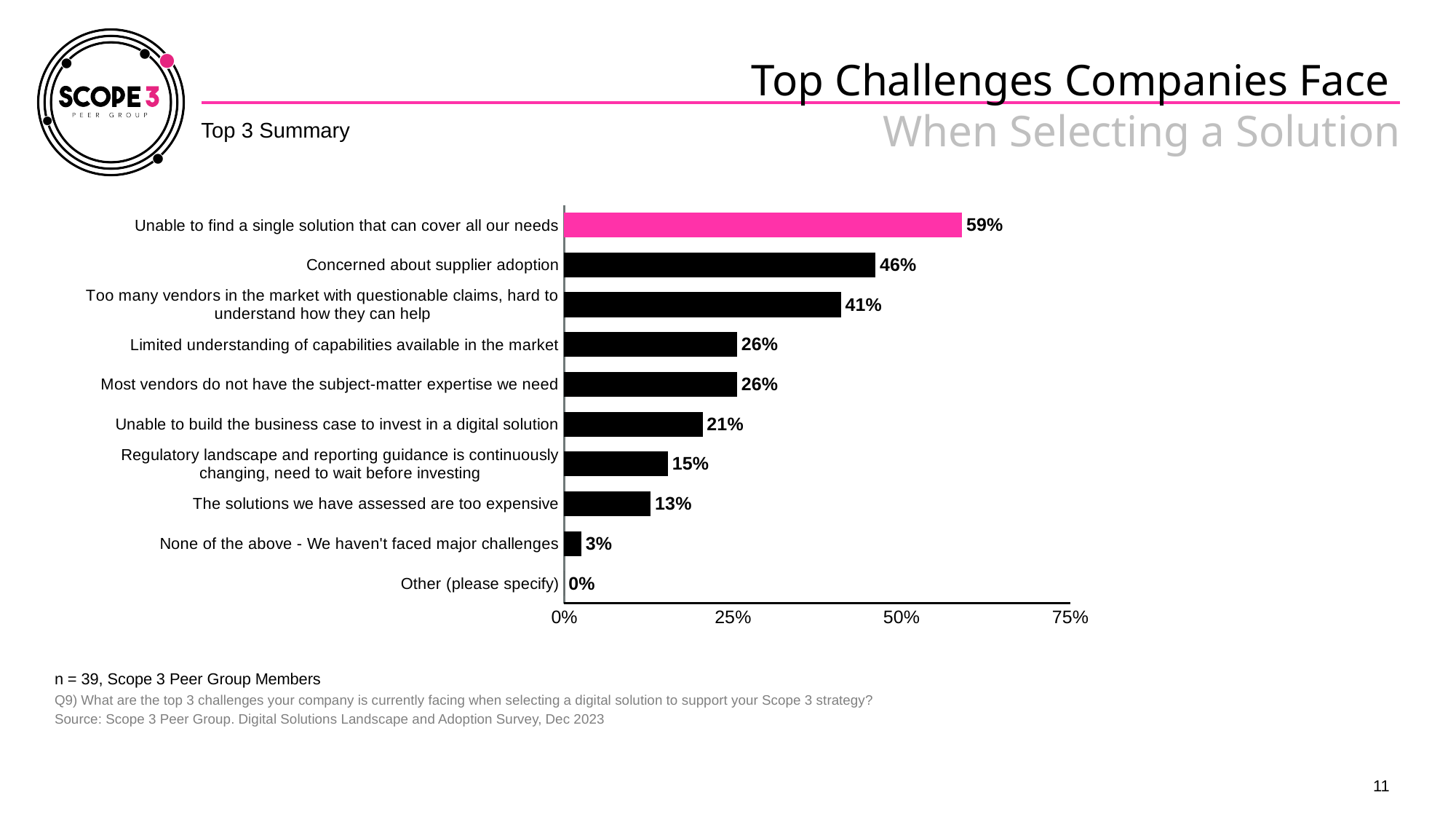
What percentage is shown for "The solutions we have assessed are too expensive"? 13% What is the difference between "Too many vendors in the market with questionable claims, hard to understand how they can help" and "Unable to build the business case to invest in a digital solution"? 20% Which challenge has the highest percentage? Unable to find a single solution that can cover all our needs What is the value for "Regulatory landscape and reporting guidance is continuously changing, need to wait before investing"? 15% What kind of chart is shown on the slide? Bar chart Which bar is highlighted in pink rather than black? Unable to find a single solution that can cover all our needs What is the value for "Concerned about supplier adoption"? 46% Which category has the lowest value on the chart? Other (please specify) Which is larger: "Concerned about supplier adoption" or "Limited understanding of capabilities available in the market"? Concerned about supplier adoption How many challenge categories are shown on the chart? 10 What percentage of respondents selected "Unable to find a single solution that can cover all our needs"? 59% What is the difference between "Unable to find a single solution that can cover all our needs" and "Concerned about supplier adoption"? 13%